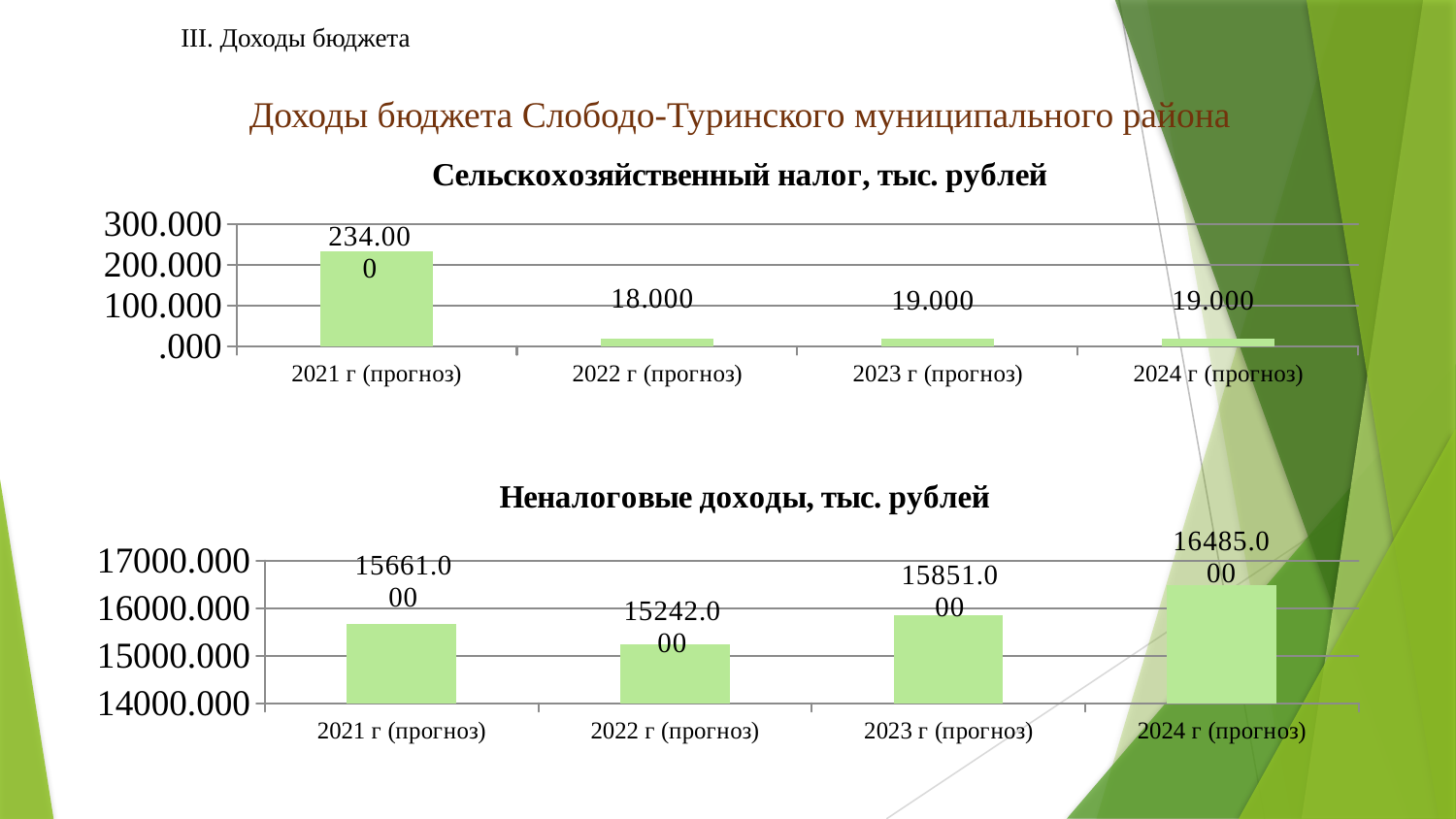
In the chart titled "Неналоговые доходы, тыс. рублей", what is the value for 2024 г (прогноз)? 16485.000 What type of chart is the chart titled "Неналоговые доходы, тыс. рублей"? Bar chart In the chart titled "Неналоговые доходы, тыс. рублей", what is the difference between the values for 2024 г (прогноз) and 2021 г (прогноз)? 824.000 In the chart titled "Сельскохозяйственный налог, тыс. рублей", what is the value for 2021 г (прогноз)? 234.000 In the chart titled "Сельскохозяйственный налог, тыс. рублей", which category has the highest value? 2021 г (прогноз) In the chart titled "Неналоговые доходы, тыс. рублей", which is larger: the value for 2021 г (прогноз) or 2023 г (прогноз)? 2023 г (прогноз) In the chart titled "Сельскохозяйственный налог, тыс. рублей", which category has the lowest value? 2022 г (прогноз) In the chart titled "Сельскохозяйственный налог, тыс. рублей", what is the difference between the values for 2021 г (прогноз) and 2023 г (прогноз)? 215.000 In the chart titled "Сельскохозяйственный налог, тыс. рублей", how many categories are shown on the x axis? 4 In the chart titled "Неналоговые доходы, тыс. рублей", which category has the lowest value? 2022 г (прогноз) In the chart titled "Сельскохозяйственный налог, тыс. рублей", what is the value for 2022 г (прогноз)? 18.000 In the chart titled "Неналоговые доходы, тыс. рублей", what is the value for 2022 г (прогноз)? 15242.000